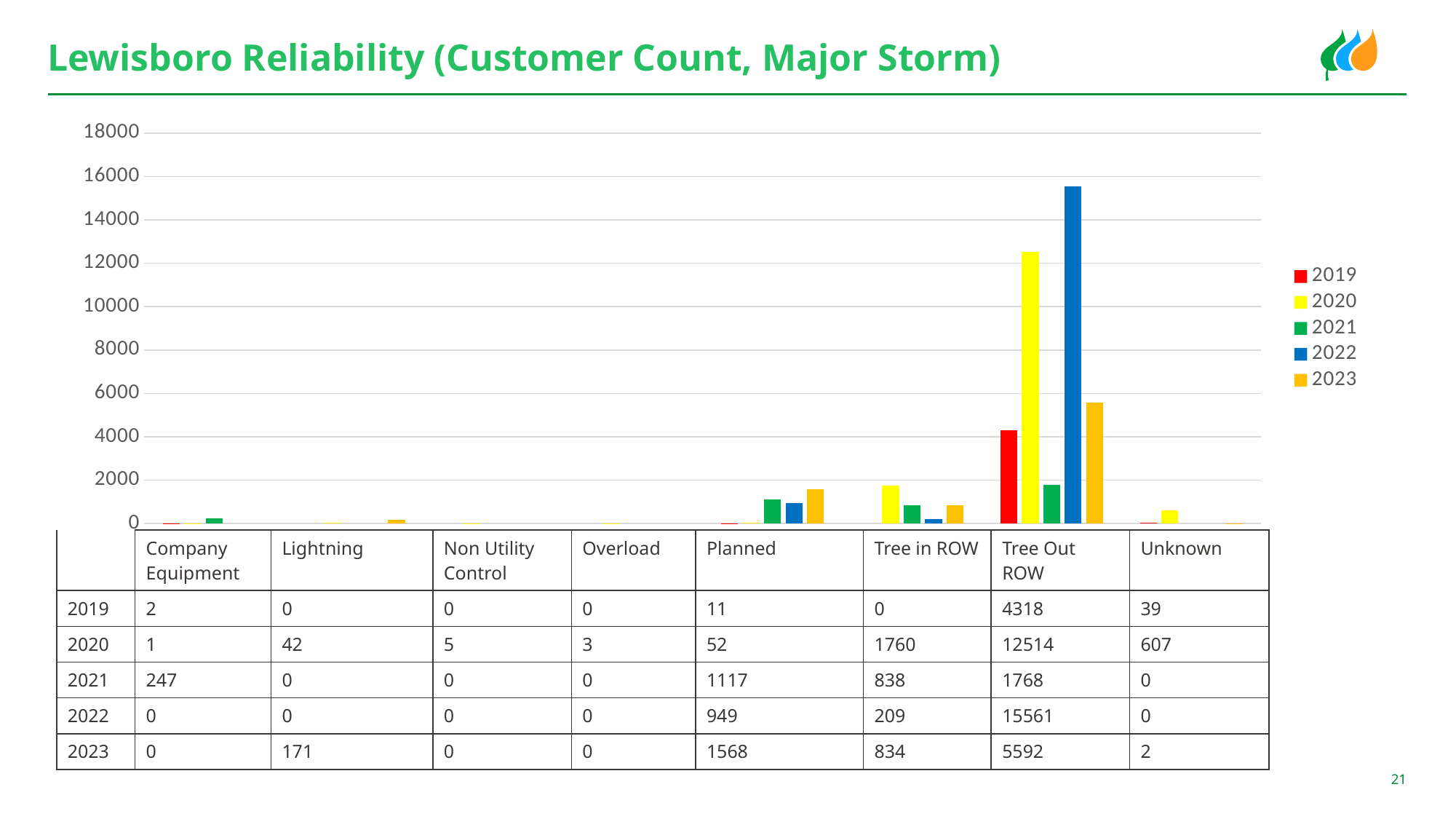
What is the value for Tree in ROW in 2020? 1760 How many series does the legend list? 5 What is the difference between the Tree Out ROW values for 2022 and 2020? 3047 What kind of chart is shown on the slide? Bar chart What is the value for Planned in 2023? 1568 Which year has the lowest value for Tree Out ROW? 2021 How many categories are shown on the x axis? 8 What colour represents 2022 in the legend? Blue Is the value for Tree Out ROW in 2023 greater or less than 4000? greater Which is larger, the Planned value for 2021 or for 2022? 2021 What is the value for Tree Out ROW in 2022? 15561 Which category has the highest value for 2019? Tree Out ROW